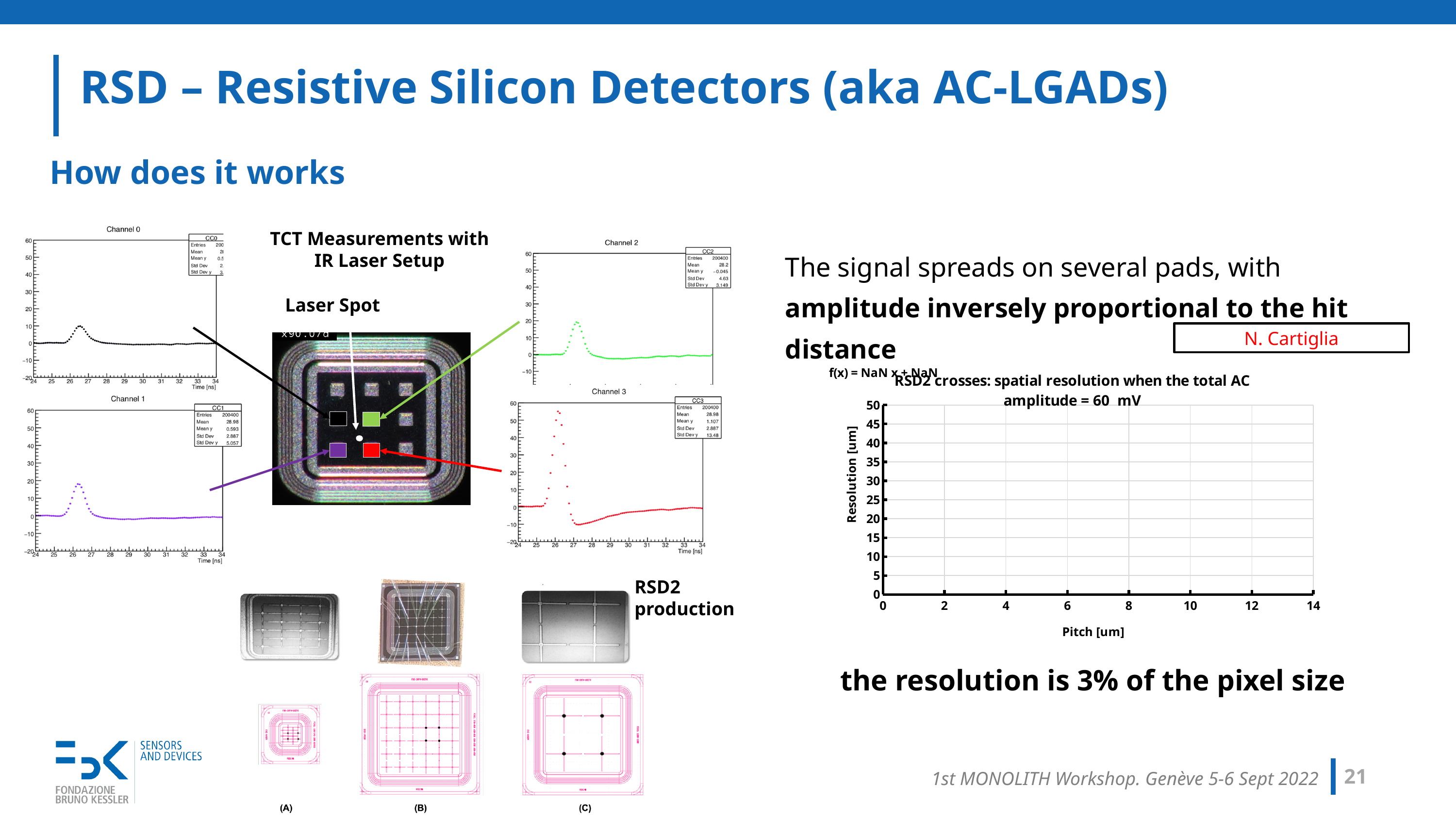
In the Channel 3 plot, what Std Dev y value is shown in the CC3 statistics box? 13.48 What is the y-axis label of the chart titled "RSD2 crosses: spatial resolution when the total AC amplitude = 60 mV"? Resolution [um] In the Channel 2 plot, what Std Dev value is shown in the CC2 statistics box? 4.63 What is the x-axis label of the chart titled "RSD2 crosses: spatial resolution when the total AC amplitude = 60 mV"? Pitch [um] In the Channel 2 plot, is the peak value of the signal greater or less than 30? less In the Channel 3 plot, is the peak value of the signal greater or less than 40? greater In the Channel 1 plot, is the peak value of the signal greater or less than 30? less Which has the higher signal peak, the Channel 3 plot or the Channel 0 plot? Channel 3 In the Channel 2 plot, how many Entries are listed in the CC2 statistics box? 200400 Which has the higher signal peak, the Channel 1 plot or the Channel 0 plot? Channel 1 Among the Channel 0, Channel 1, Channel 2 and Channel 3 plots, which channel shows the highest signal peak? Channel 3